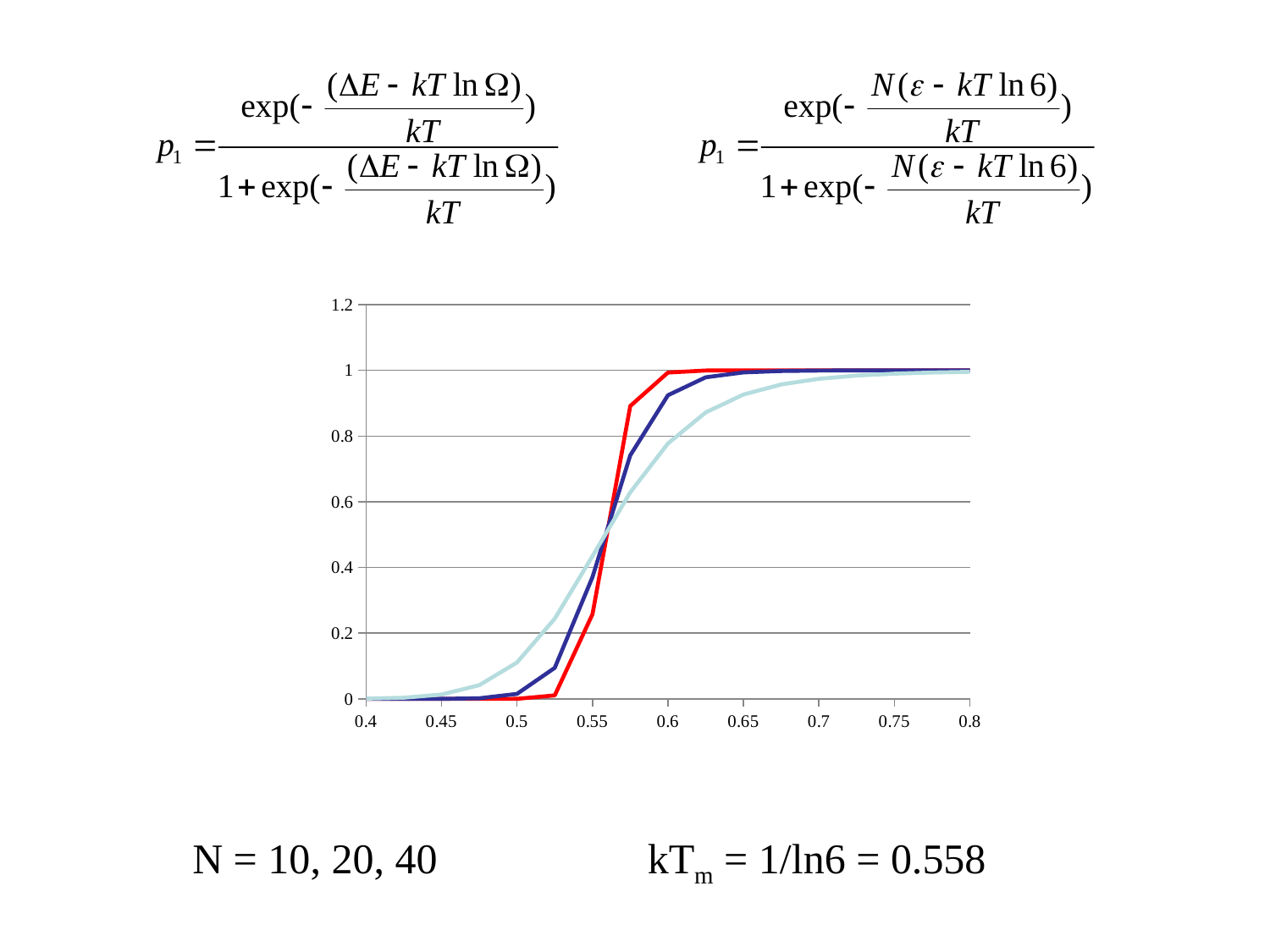
At x = 0.6, which line has the larger value, the red line or the light blue line? red line Is the value of the red line at x = 0.6 greater or less than 0.8? greater Is the value of the red line at x = 0.5 greater or less than 0.2? less Do the plotted values rise or fall as the x-axis value increases from 0.4 to 0.8? rise What is the highest tick value shown on the y-axis? 1.2 How many lines are plotted on the chart? 3 Is the value of the light blue line at x = 0.7 greater or less than 0.8? greater At x = 0.5, which line has the larger value, the light blue line or the red line? light blue line What kind of chart is shown on the slide? line chart What range does the x-axis cover, from its lowest to its highest tick? 0.4 to 0.8